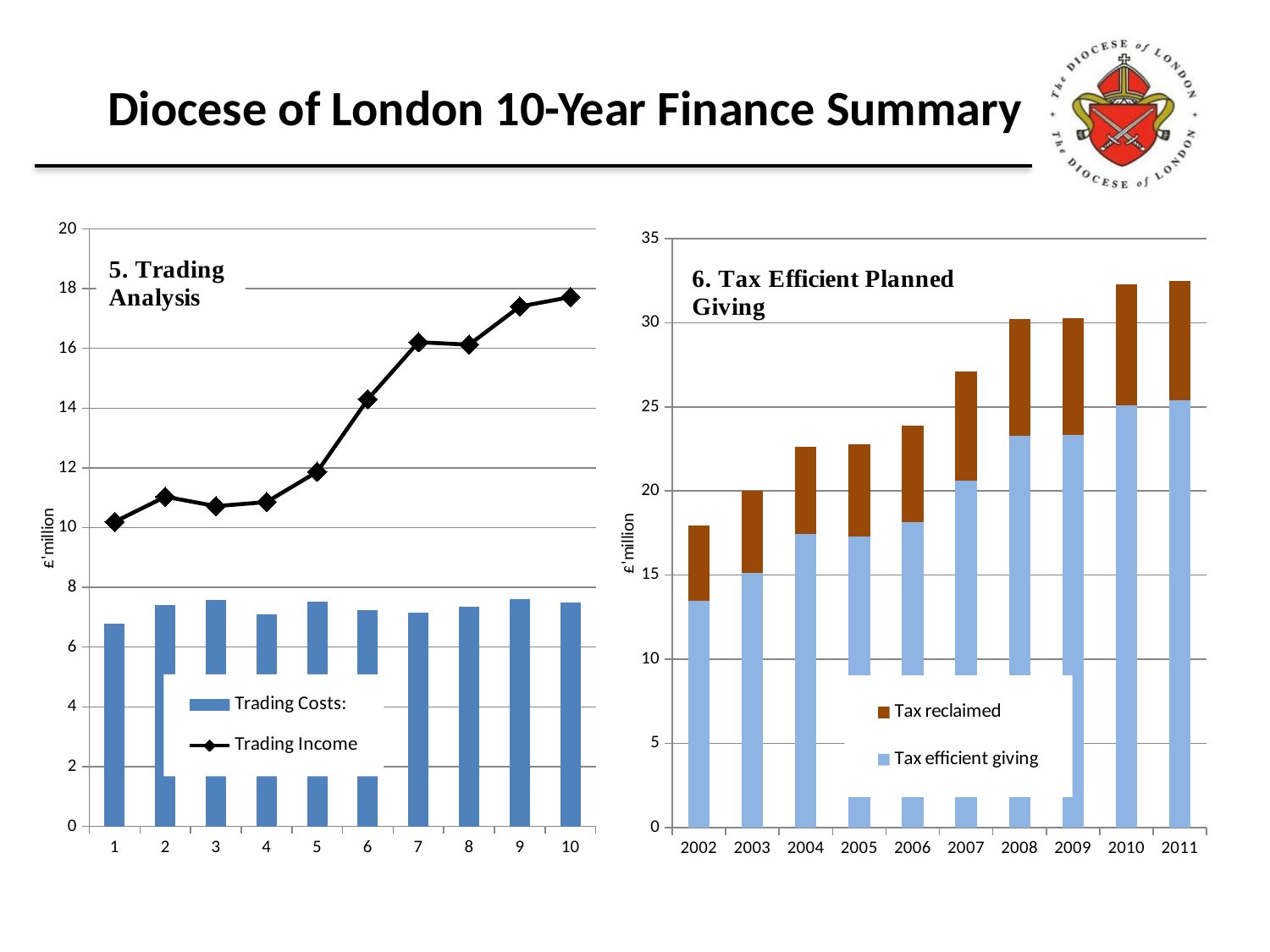
In the '5. Trading Analysis' chart, is the Trading Income value for year 1 greater or less than 12? less In the '6. Tax Efficient Planned Giving' chart, is the total bar for 2007 greater or less than 25? greater In the '5. Trading Analysis' chart, does Trading Income generally rise or fall from year 1 to year 10? rise How many series does the legend of the '5. Trading Analysis' chart list? 2 In the '6. Tax Efficient Planned Giving' chart, which series is shown in brown? Tax reclaimed In the '6. Tax Efficient Planned Giving' chart, which year has the lowest total bar? 2002 In the '5. Trading Analysis' chart, is the Trading Income value for year 10 greater or less than 16? greater What kind of chart is the '6. Tax Efficient Planned Giving' chart? stacked bar chart How many years are shown on the x axis of the '6. Tax Efficient Planned Giving' chart? 10 In the '5. Trading Analysis' chart, which is larger in year 10: Trading Income or Trading Costs? Trading Income